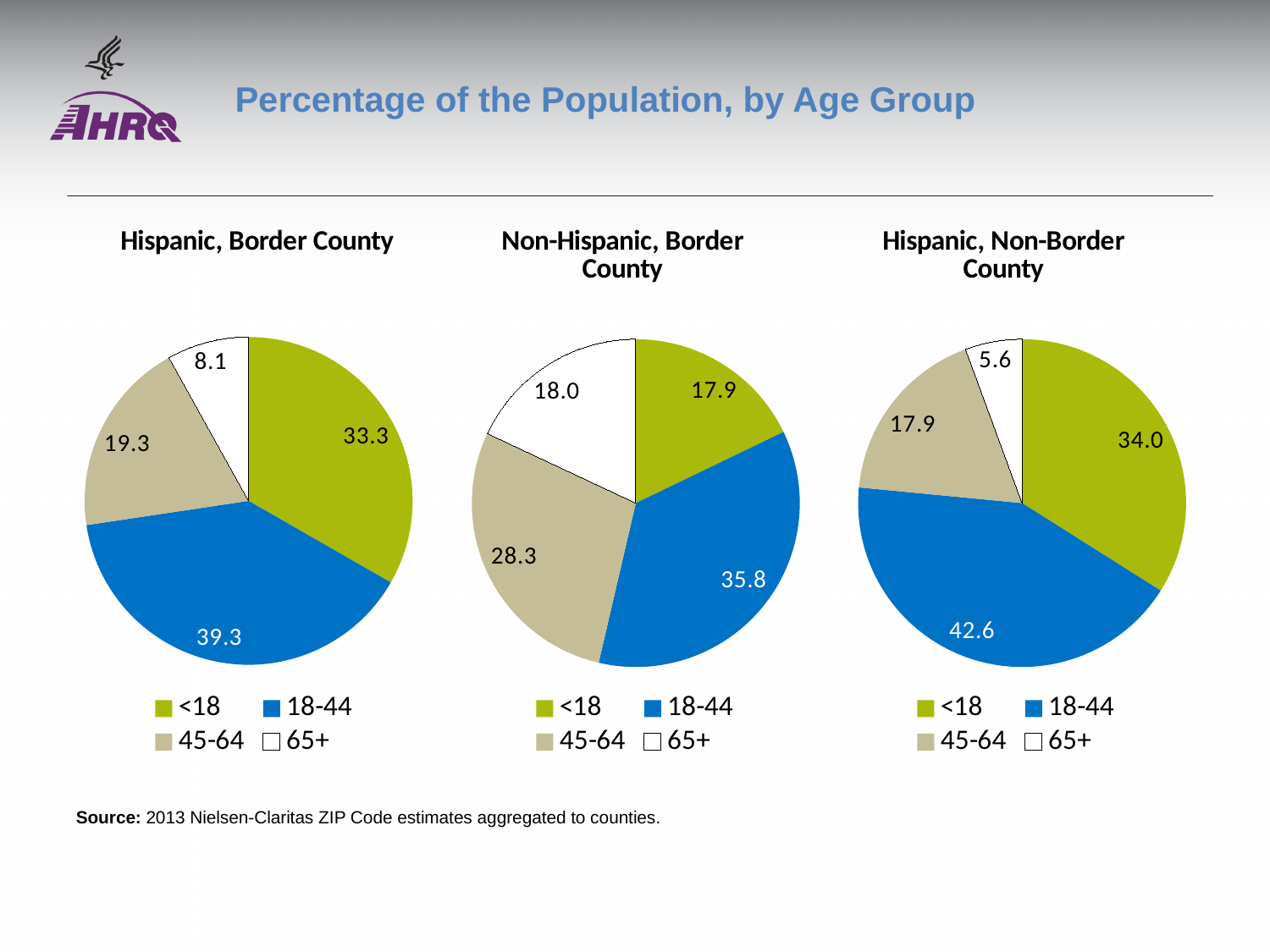
In the 'Non-Hispanic, Border County' chart, which is larger: the 45-64 slice or the <18 slice? 45-64 In the 'Hispanic, Non-Border County' chart, which age group has the smallest share? 65+ In the 'Hispanic, Border County' chart, what is the value for the 18-44 age group? 39.3 What type of chart is used for 'Non-Hispanic, Border County'? Pie chart How many entries does the legend of the 'Hispanic, Non-Border County' chart list? 4 In the 'Hispanic, Non-Border County' chart, what is the value for the <18 age group? 34.0 In the 'Hispanic, Non-Border County' chart, what is the difference between the 45-64 and 65+ values? 12.3 In the 'Hispanic, Border County' chart, what is the difference between the 18-44 and <18 values? 6.0 What is the title of the slide? Percentage of the Population, by Age Group How many slices does the 'Hispanic, Border County' pie chart have? 4 In the 'Non-Hispanic, Border County' chart, which age group has the largest share? 18-44 In the 'Non-Hispanic, Border County' chart, what is the value for the 65+ age group? 18.0